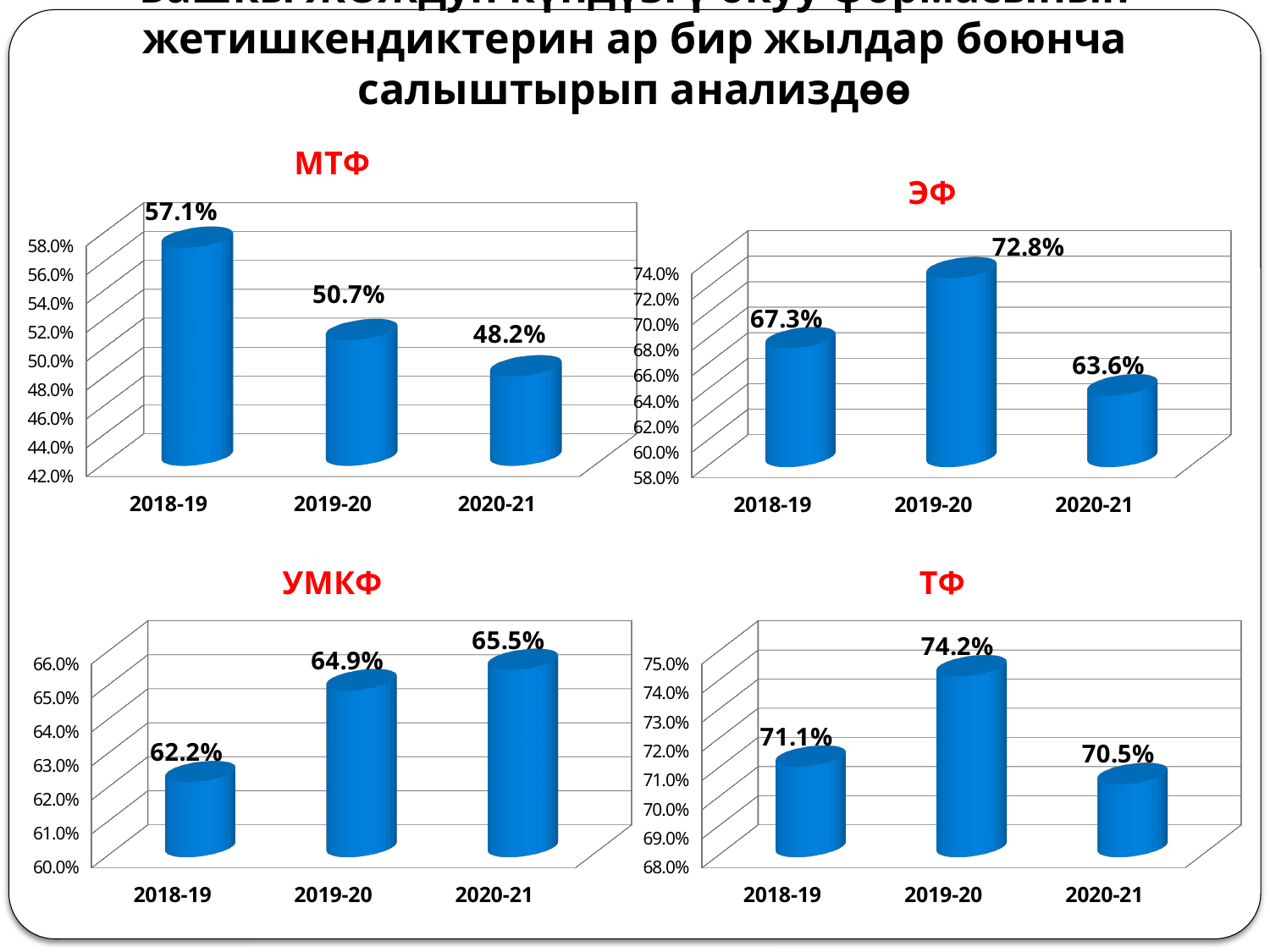
In the ТФ chart, what is the value for 2018-19? 71.1% In the УМКФ chart, which year has the lowest value? 2018-19 How many charts are on the slide? 4 In the МТФ chart, do the values rise or fall from 2018-19 to 2020-21? fall In the ЭФ chart, which year has the highest value? 2019-20 In the ЭФ chart, which is larger, the value for 2018-19 or the value for 2020-21? 2018-19 In the УМКФ chart, do the values rise or fall from 2018-19 to 2020-21? rise In the МТФ chart, what is the value for 2018-19? 57.1% In the МТФ chart, which year has the lowest value? 2020-21 In the ТФ chart, what is the difference between the 2019-20 and 2020-21 values? 3.7% In the ЭФ chart, what is the value for 2019-20? 72.8% In the УМКФ chart, what is the value for 2020-21? 65.5%